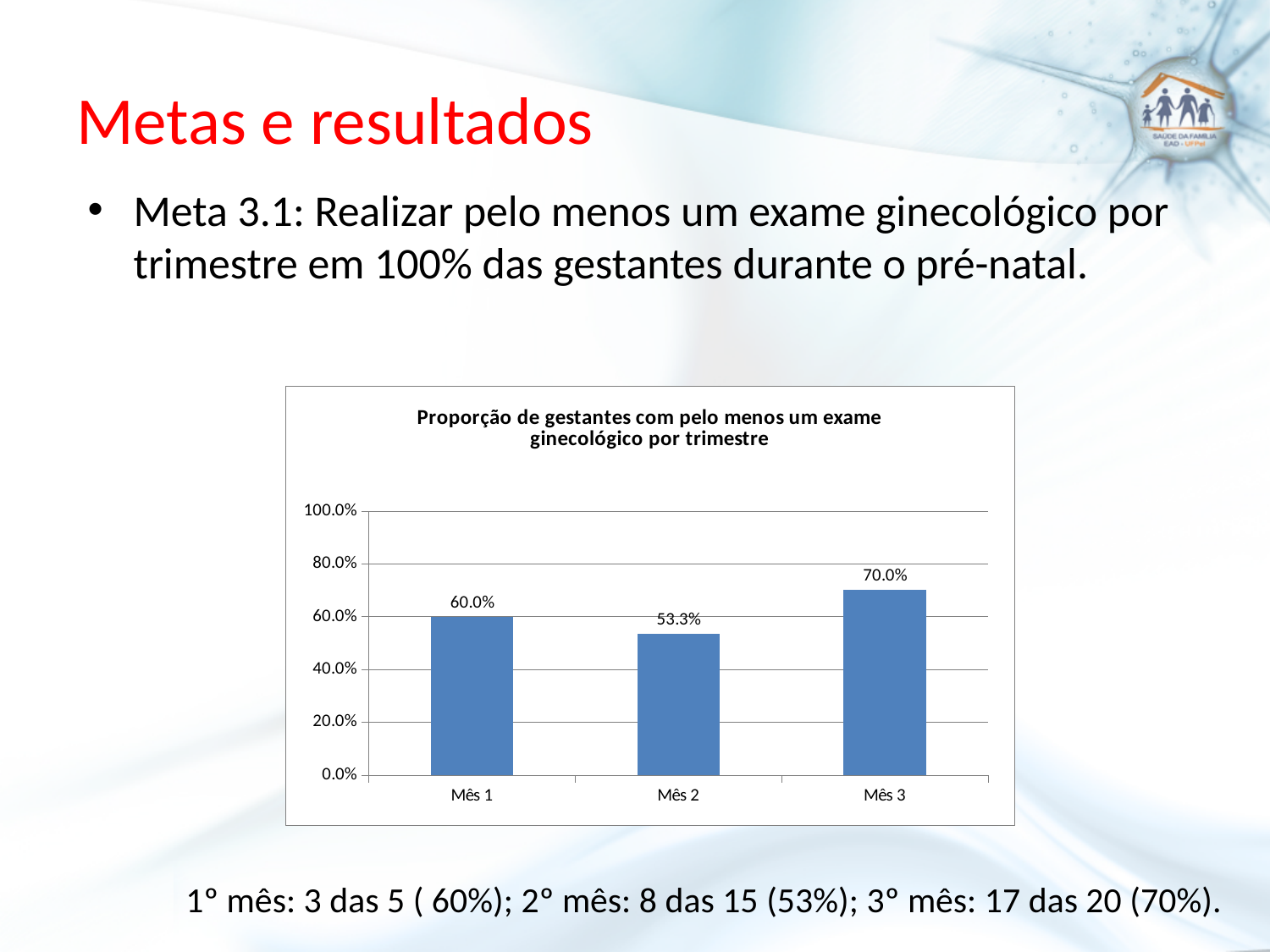
What is the value for Mês 1? 60.0% What is the difference between the values for Mês 3 and Mês 1? 10.0% What is the difference between the values for Mês 1 and Mês 2? 6.7% What is the value for Mês 3? 70.0% What kind of chart is shown on the slide? bar chart Which month has the lowest proportion? Mês 2 Is the value for Mês 3 greater or less than 80.0%? less How many months are shown on the x axis? 3 Which month has the highest proportion? Mês 3 Which is larger, the value for Mês 1 or the value for Mês 2? Mês 1 What is the title of the chart? Proporção de gestantes com pelo menos um exame ginecológico por trimestre What is the value for Mês 2? 53.3%